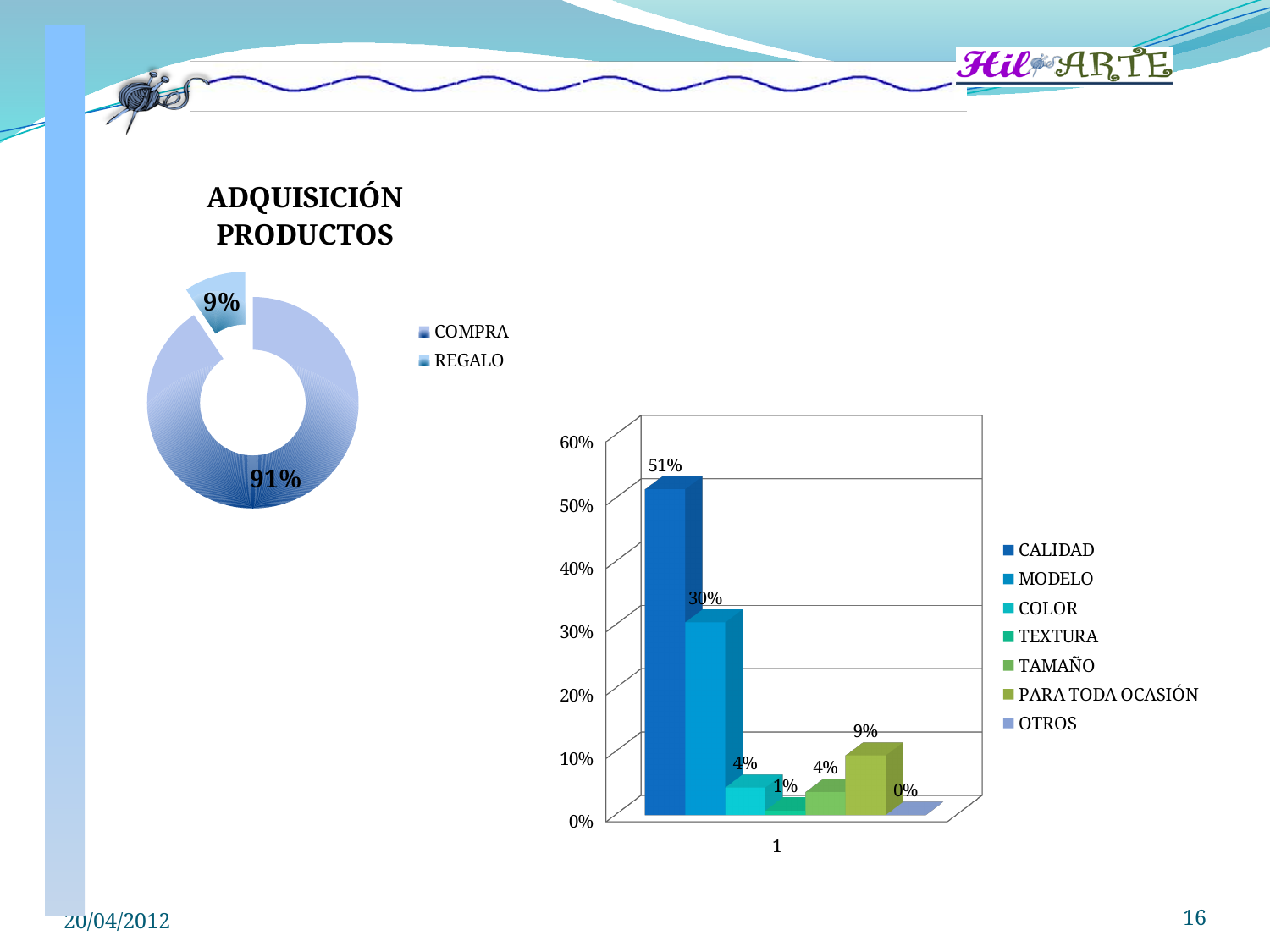
In the bar chart on the right, what is the value for MODELO? 30% In the bar chart on the right, what is the value for PARA TODA OCASIÓN? 9% What kind of chart is the ADQUISICIÓN PRODUCTOS chart? Doughnut chart What kind of chart is the chart on the right of the slide? Bar chart In the bar chart on the right, how many series does the legend list? 7 In the ADQUISICIÓN PRODUCTOS chart, what share does COMPRA have? 91% In the bar chart on the right, what is the difference between CALIDAD and MODELO? 21% How many series does the legend of the ADQUISICIÓN PRODUCTOS chart list? 2 In the bar chart on the right, which series has the lowest value? OTROS In the ADQUISICIÓN PRODUCTOS chart, what share does REGALO have? 9% In the bar chart on the right, what is the value for CALIDAD? 51% In the bar chart on the right, which series has the highest value? CALIDAD